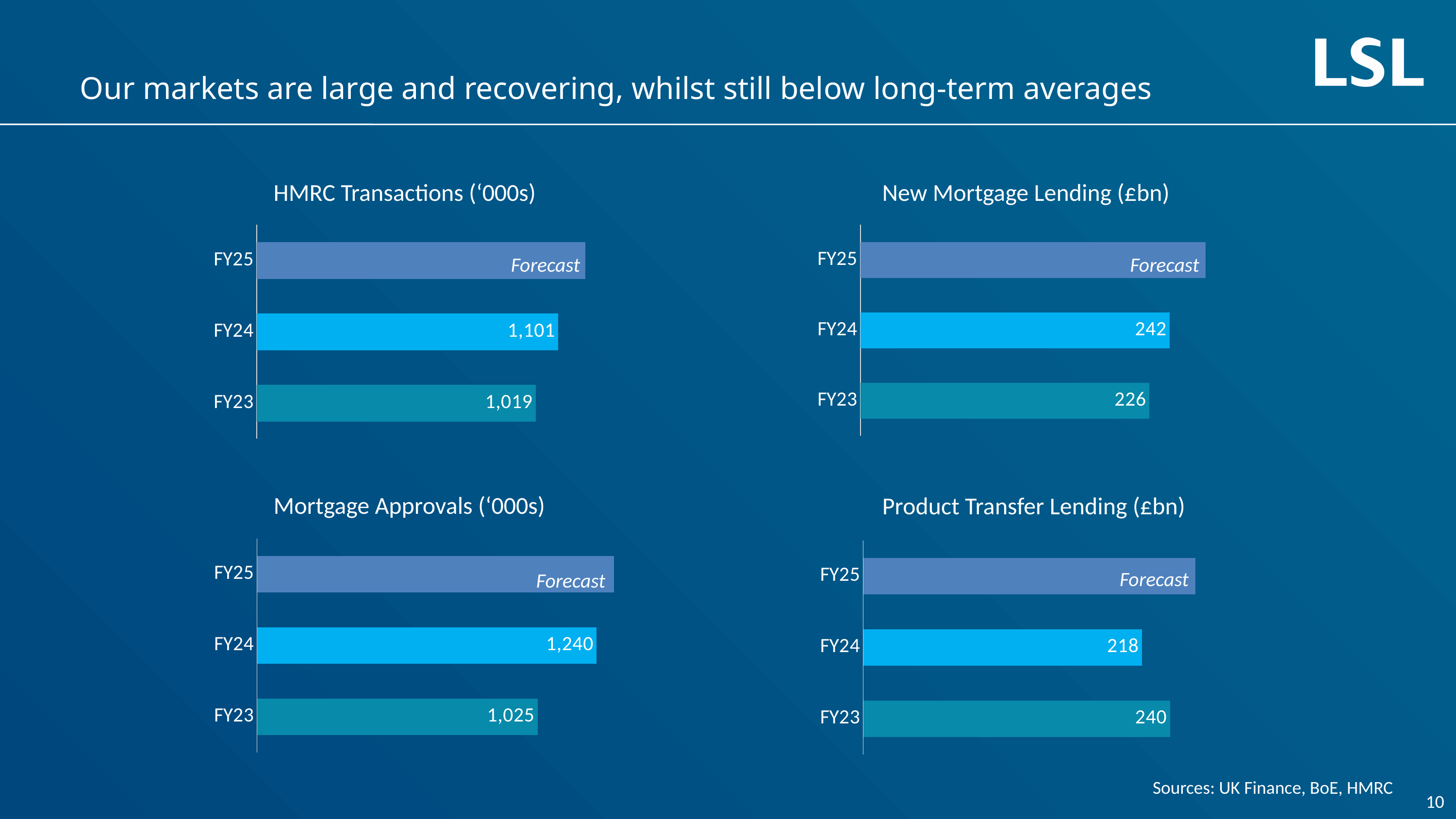
In the New Mortgage Lending (£bn) chart, what is the difference between FY24 and FY23? 16 In the New Mortgage Lending (£bn) chart, what is the value for FY24? 242 In the Product Transfer Lending (£bn) chart, which is larger, FY23 or FY24? FY23 How many categories does the Mortgage Approvals ('000s) chart show? 3 In the HMRC Transactions ('000s) chart, what is the value for FY23? 1,019 In the HMRC Transactions ('000s) chart, what is the value for FY24? 1,101 What kind of chart is the New Mortgage Lending (£bn) chart? Bar chart In the Product Transfer Lending (£bn) chart, what is the difference between FY23 and FY24? 22 In the Mortgage Approvals ('000s) chart, what is the difference between FY24 and FY23? 215 In the HMRC Transactions ('000s) chart, which is larger, FY23 or FY24? FY24 In the Mortgage Approvals ('000s) chart, what is the value for FY23? 1,025 In the Product Transfer Lending (£bn) chart, what is the value for FY24? 218